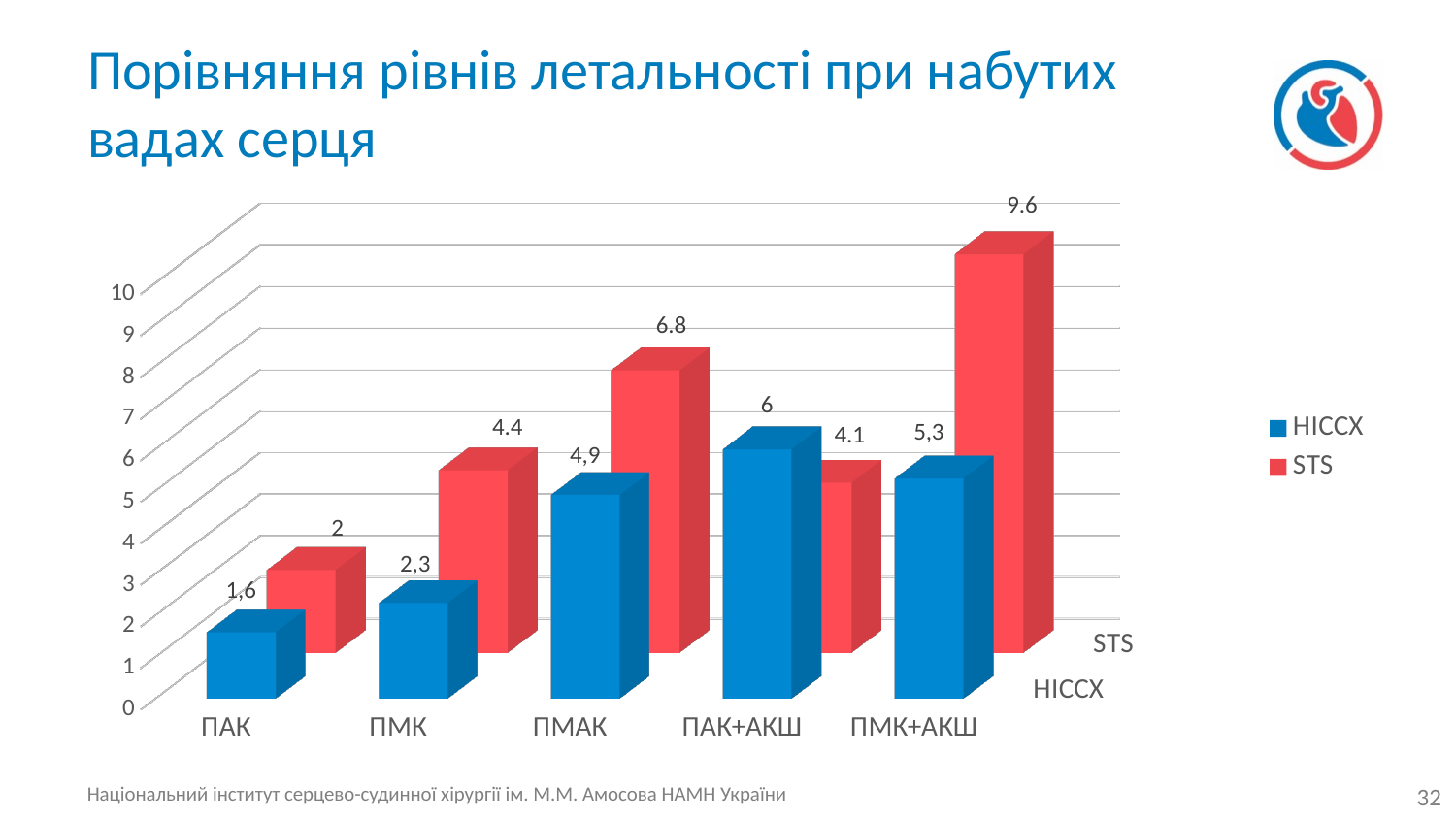
Which category has the lowest НІССХ value? ПАК What is the НІССХ value for ПАК? 1,6 For ПАК+АКШ, which series has the larger value, НІССХ or STS? НІССХ What is the НІССХ value for ПМК+АКШ? 5,3 How many series does the legend list? 2 What is the STS value for ПМАК? 6.8 What type of chart is shown on the slide? bar chart What is the difference between the STS value and the НІССХ value for ПАК+АКШ? 1.9 Which category has the highest STS value? ПМК+АКШ How many categories are shown on the x axis? 5 What is the STS value for ПМК? 4.4 Which colour represents the STS series in the legend? red